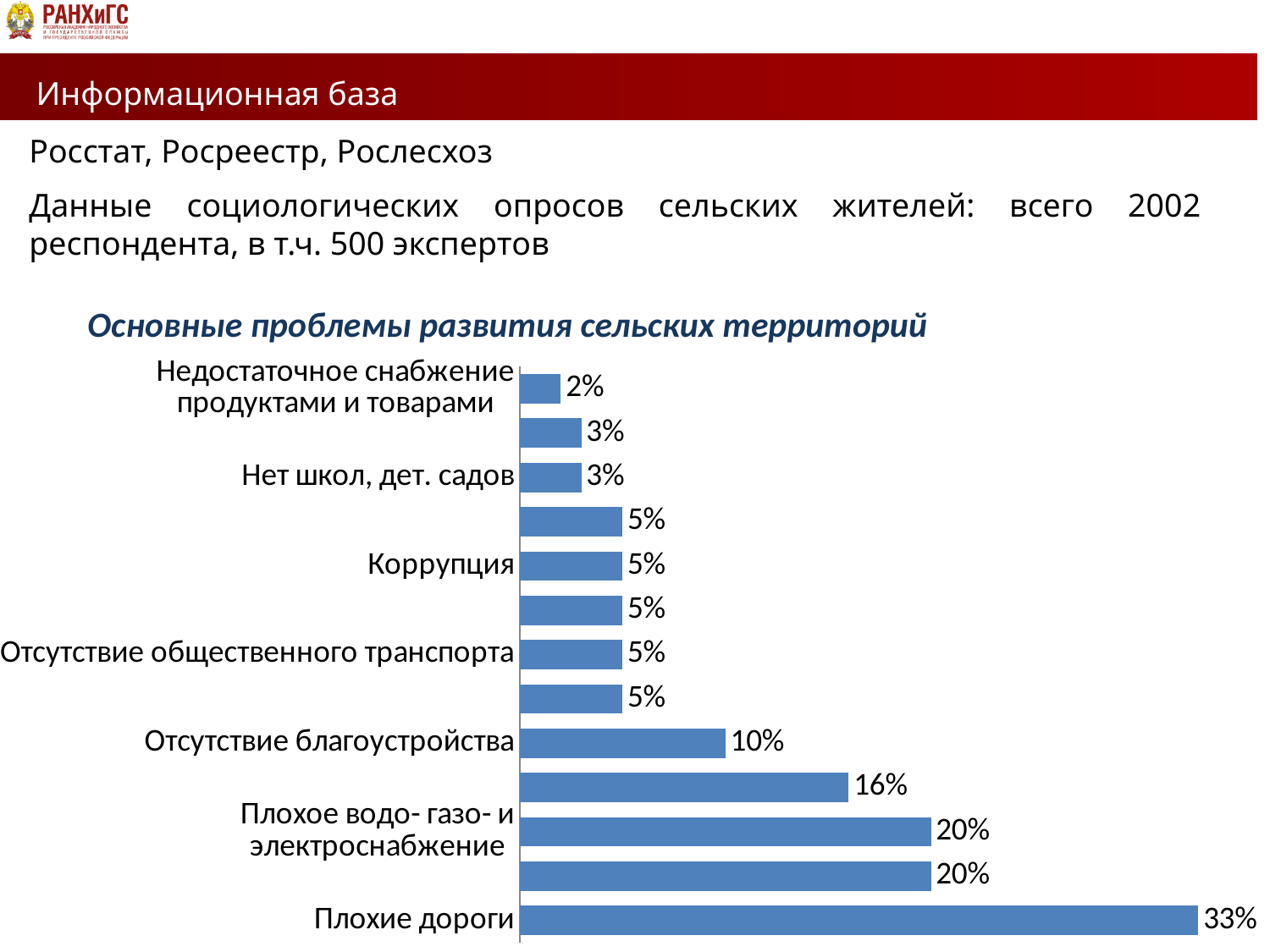
What is the difference between the values for Плохие дороги and Плохое водо- газо- и электроснабжение? 13% What kind of chart is shown on the slide? Bar chart Which category has the highest value? Плохие дороги What is the value for Плохие дороги? 33% How many bars are plotted in the chart? 13 What is the value for Плохое водо- газо- и электроснабжение? 20% What is the value for Коррупция? 5% Which category has the lowest value? Недостаточное снабжение продуктами и товарами Which is larger: the value for Отсутствие благоустройства or the value for Нет школ, дет. садов? Отсутствие благоустройства What is the value for Недостаточное снабжение продуктами и товарами? 2% What is the title of the chart? Основные проблемы развития сельских территорий What is the value for Отсутствие благоустройства? 10%